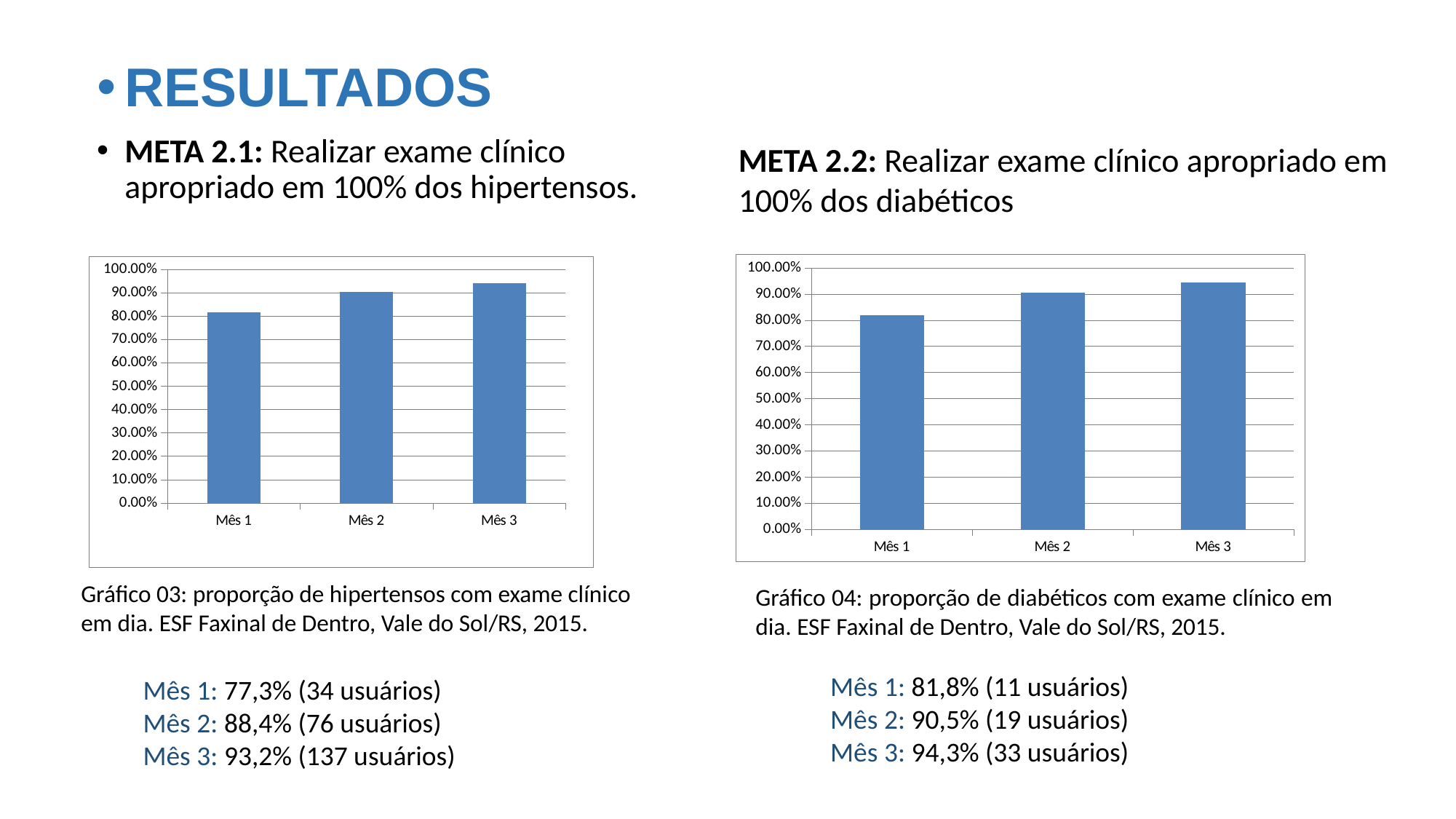
In Gráfico 04 (right chart), do the values rise or fall from Mês 1 to Mês 3? Rise In Gráfico 04 (right chart), what is the value for Mês 1? 81,8% In Gráfico 04 (right chart), what is the value for Mês 2? 90,5% In Gráfico 03 (left chart), is the value for Mês 3 greater or less than 90.00%? greater In Gráfico 03 (left chart), which month has the lowest value? Mês 1 In Gráfico 04 (right chart), which month has the highest value? Mês 3 In Gráfico 04 (right chart), what is the value for Mês 3? 94,3% In Gráfico 04 (right chart), what is the difference between the values for Mês 3 and Mês 1? 12,5 percentage points How many months (categories) are shown in Gráfico 04 (right chart)? 3 In Gráfico 03 (left chart), which is larger, the value for Mês 2 or Mês 3? Mês 3 What kind of chart is Gráfico 03 (left chart)? Bar chart In Gráfico 03 (left chart), is the value for Mês 1 greater or less than 90.00%? less